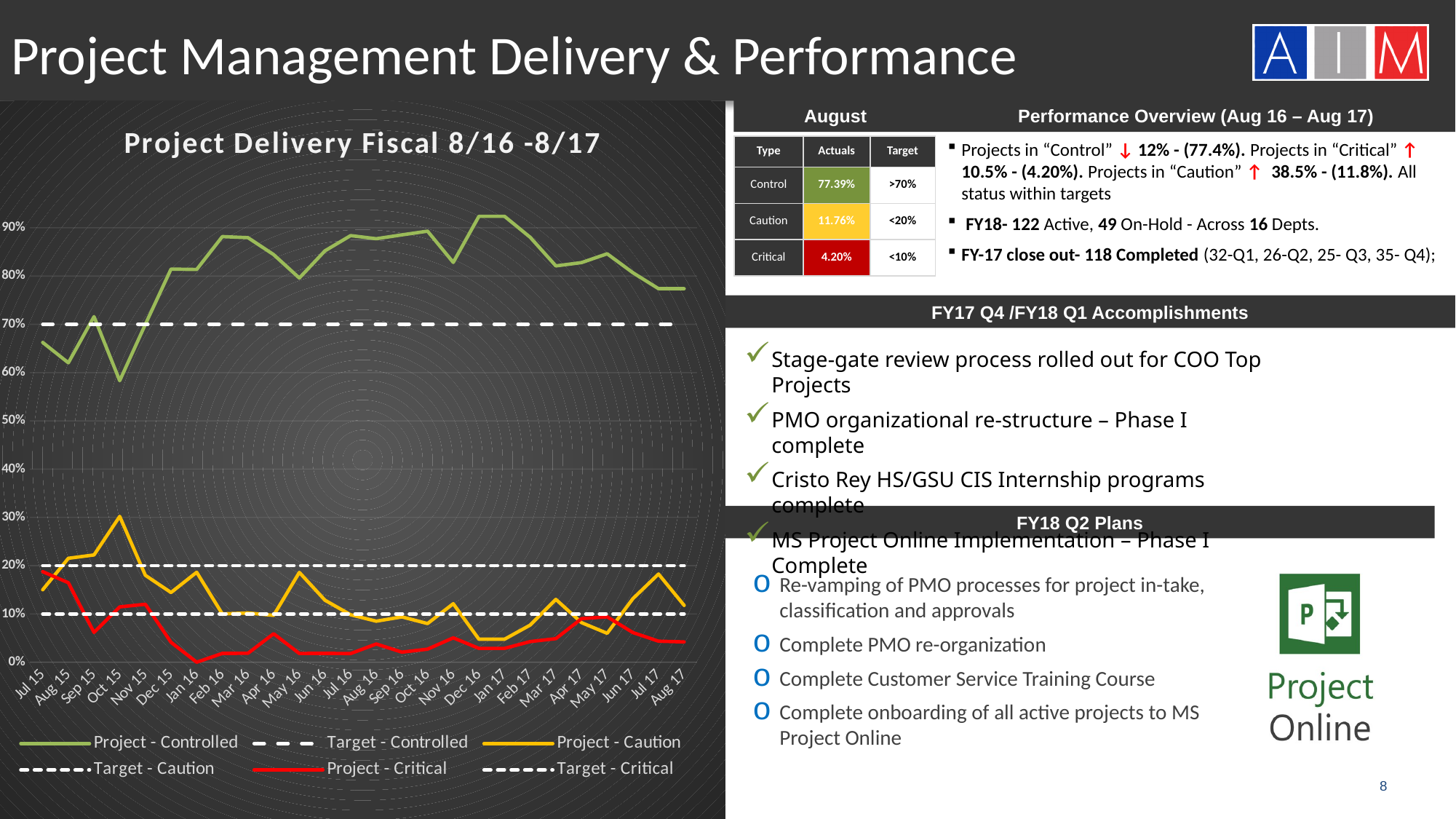
In which month is the Project - Controlled line at its lowest? Oct 15 What kind of chart is shown on the slide? line chart In which month is the Project - Caution line at its highest? Oct 15 What is the title of the chart? Project Delivery Fiscal 8/16 -8/17 Is the Project - Controlled value for Oct 15 greater or less than 60%? less At Aug 17, which is higher: Project - Caution or Project - Critical? Project - Caution How many months are plotted along the x axis of the chart? 26 What value does the Target - Caution line sit at? 20% What value does the Target - Controlled line sit at? 70% How many series does the chart legend list? 6 Is the Project - Controlled value for Aug 17 greater or less than 70%? greater What value does the Target - Critical line sit at? 10%